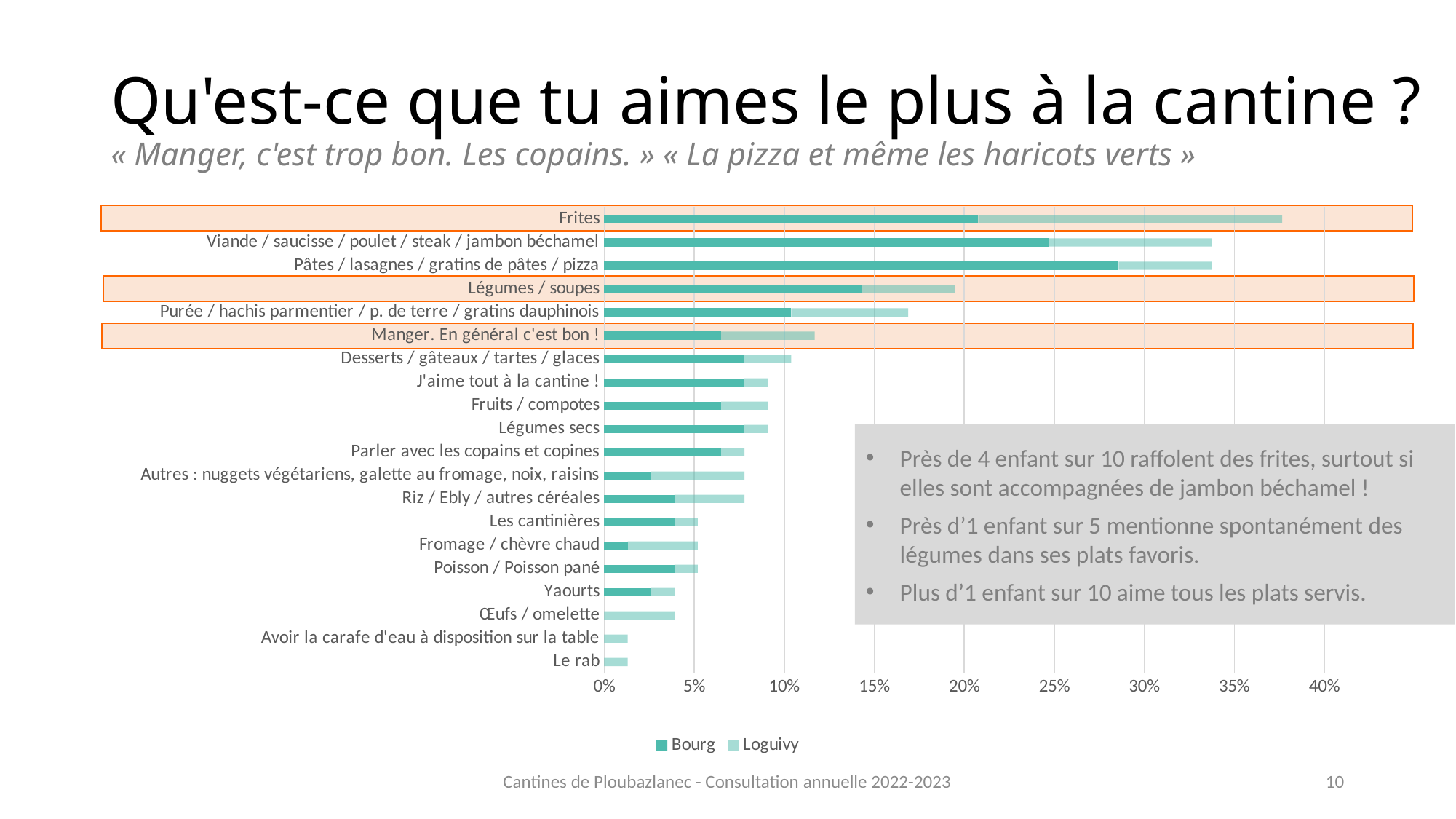
Is the total value for Frites greater or less than 35%? greater Is the Bourg value for 'Manger. En général c'est bon !' greater or less than 10%? less Is the total value for Légumes / soupes greater or less than 15%? greater Which category has the longest total bar? Frites Which has the larger Bourg value, Pâtes / lasagnes / gratins de pâtes / pizza or Viande / saucisse / poulet / steak / jambon béchamel? Pâtes / lasagnes / gratins de pâtes / pizza What are the two series named in the legend? Bourg and Loguivy What kind of chart is shown on the slide? Bar chart How many categories are plotted on the chart? 20 How many series does the legend list? 2 Which has the larger total bar, Frites or Viande / saucisse / poulet / steak / jambon béchamel? Frites